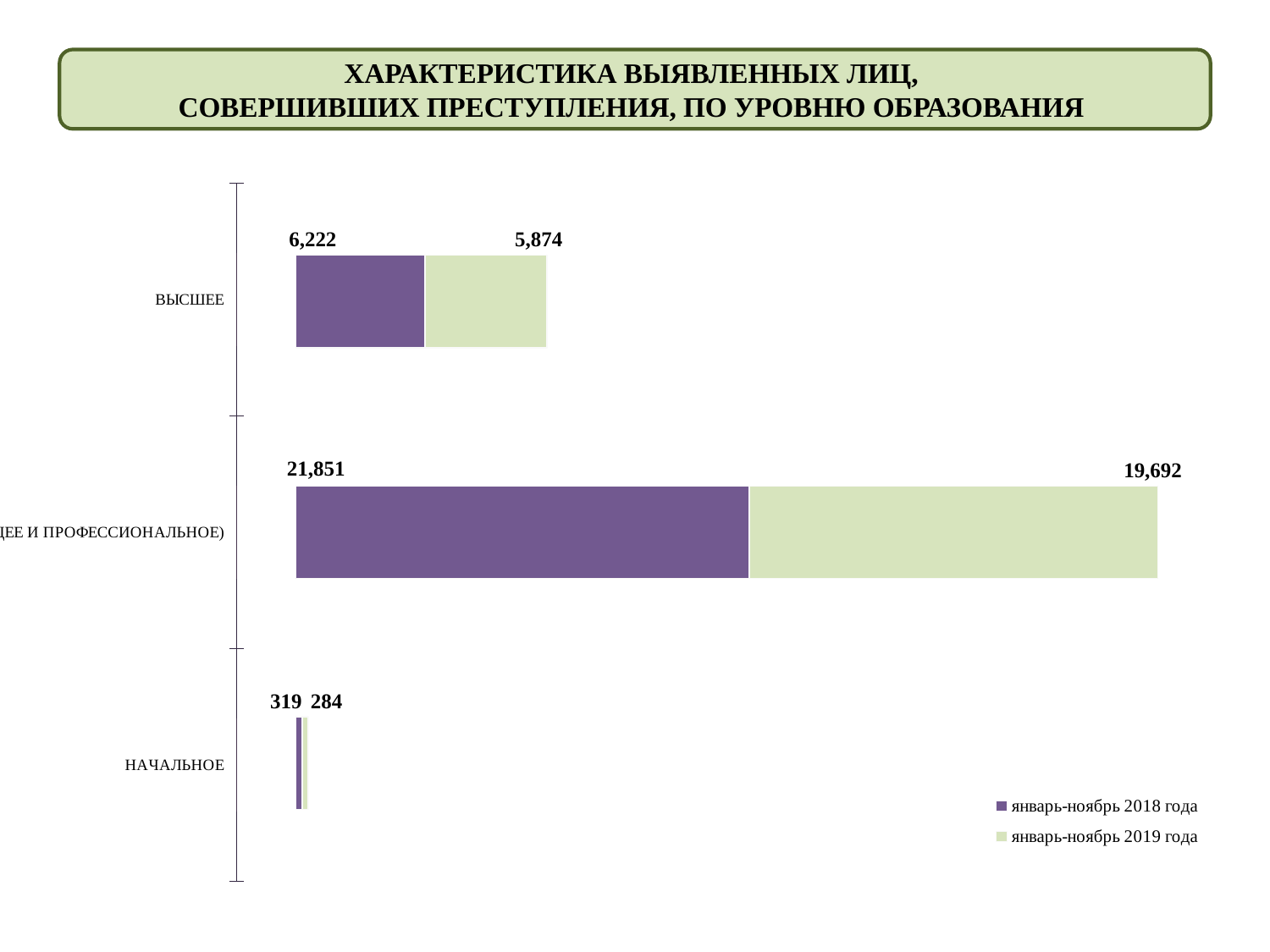
What is the value for НАЧАЛЬНОЕ in январь-ноябрь 2019 года? 284 What is the value for НАЧАЛЬНОЕ in январь-ноябрь 2018 года? 319 Which legend entry is shown in purple? январь-ноябрь 2018 года What is the difference between the 2018 and 2019 values for ВЫСШЕЕ? 348 What is the value for ВЫСШЕЕ in январь-ноябрь 2019 года? 5,874 What is the total of the stacked bar for ВЫСШЕЕ? 12,096 What type of chart is shown on the slide? Bar chart What is the difference between the 2018 and 2019 values for НАЧАЛЬНОЕ? 35 How many categories are shown on the chart? 3 Which is larger for январь-ноябрь 2019 года: ВЫСШЕЕ or НАЧАЛЬНОЕ? ВЫСШЕЕ How many series does the legend list? 2 What is the value for ВЫСШЕЕ in январь-ноябрь 2018 года? 6,222